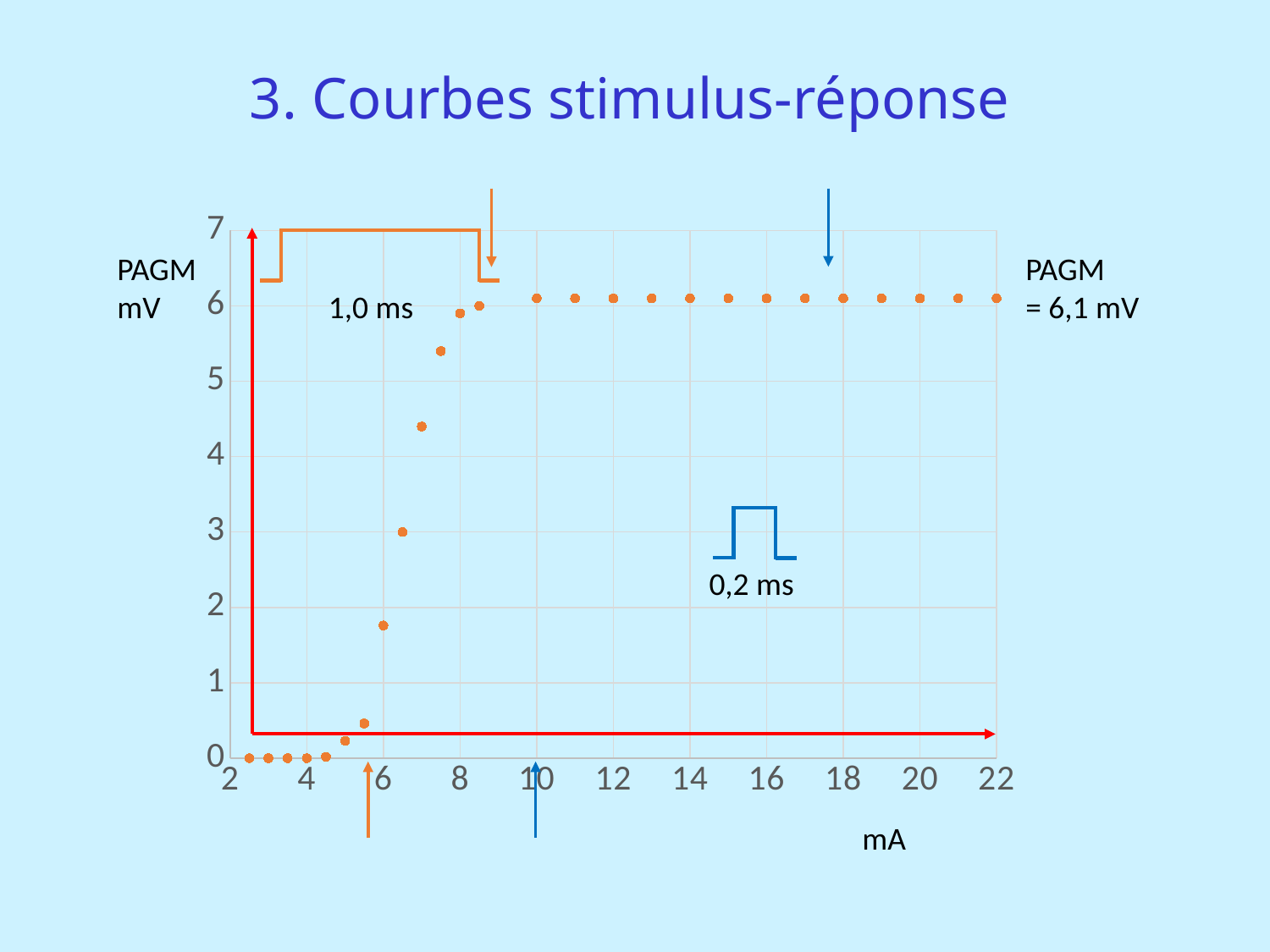
Is the value at 16 mA greater or less than 6? greater Which is larger, the value at 6.5 mA or the value at 7.5 mA? 7.5 mA Is the value at 6 mA greater or less than 2? less What is the title of the slide's chart? 3. Courbes stimulus-réponse What PAGM value does the plateau of the curve reach, according to the annotation on the chart? 6,1 mV Do the plotted values rise or fall as the stimulus intensity increases from 5 mA to 9 mA? rise Is the value at 4 mA greater or less than 1? less Which is larger, the value at 6 mA or the value at 8 mA? 8 mA What kind of chart is shown on the slide? scatter chart What unit is shown on the x axis of the chart? mA